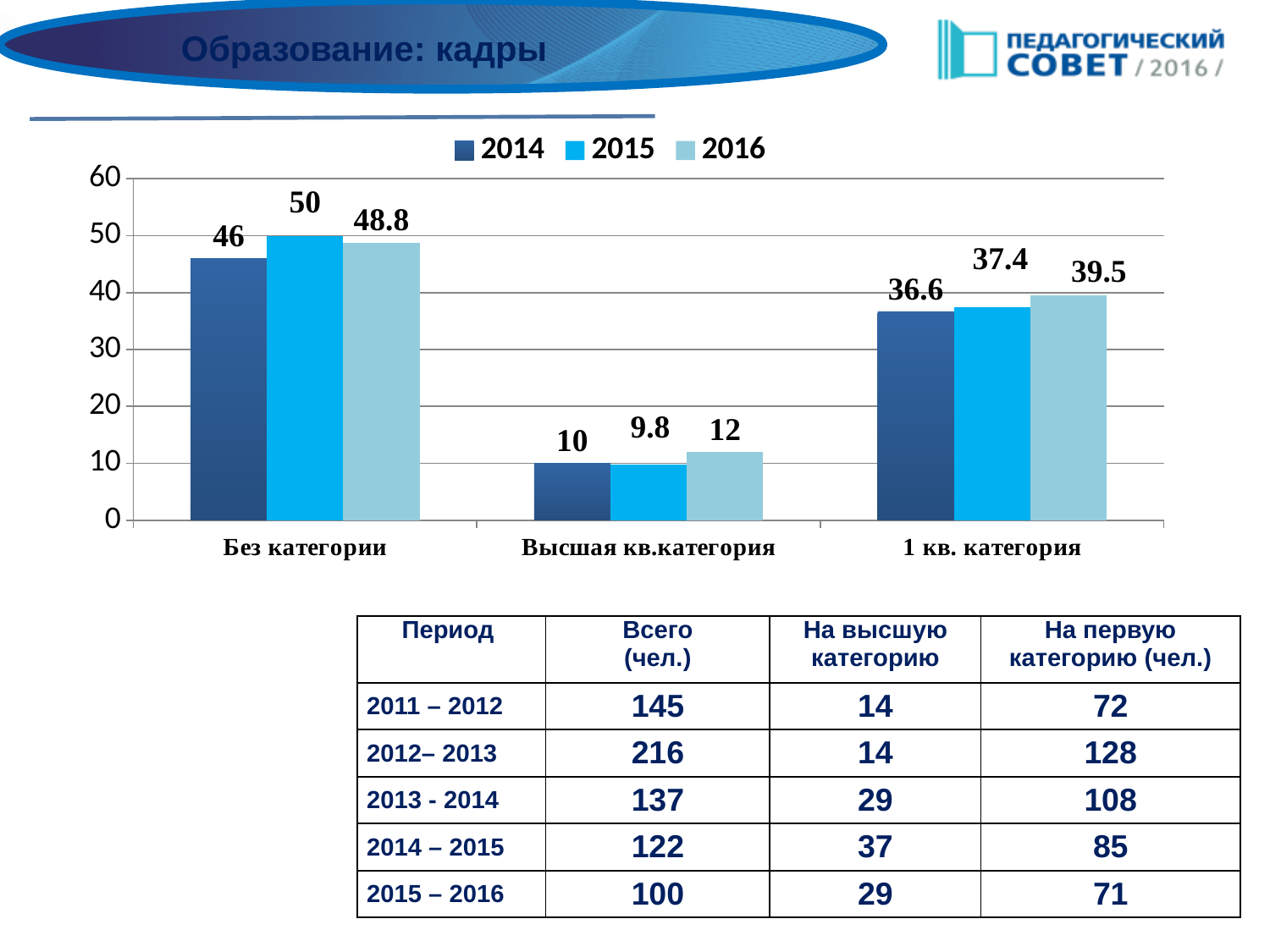
How many series does the chart legend list? 3 What kind of chart is shown on the slide? Bar chart Which series is shown in the darkest blue colour in the chart? 2014 Which is larger in the 'Высшая кв.категория' category: the 2014 value or the 2015 value? 2014 What is the value for 2015 in the '1 кв. категория' category? 37.4 How many categories are shown on the x axis of the chart? 3 Which category has the lowest value for the 2015 series? Высшая кв.категория What is the difference between the 2015 and 2014 values in the 'Без категории' category? 4 What is the difference between the 2016 and 2014 values in the '1 кв. категория' category? 2.9 What is the value for 2014 in the 'Без категории' category? 46 What is the value for 2016 in the 'Высшая кв.категория' category? 12 Which category has the highest value for the 2016 series? Без категории